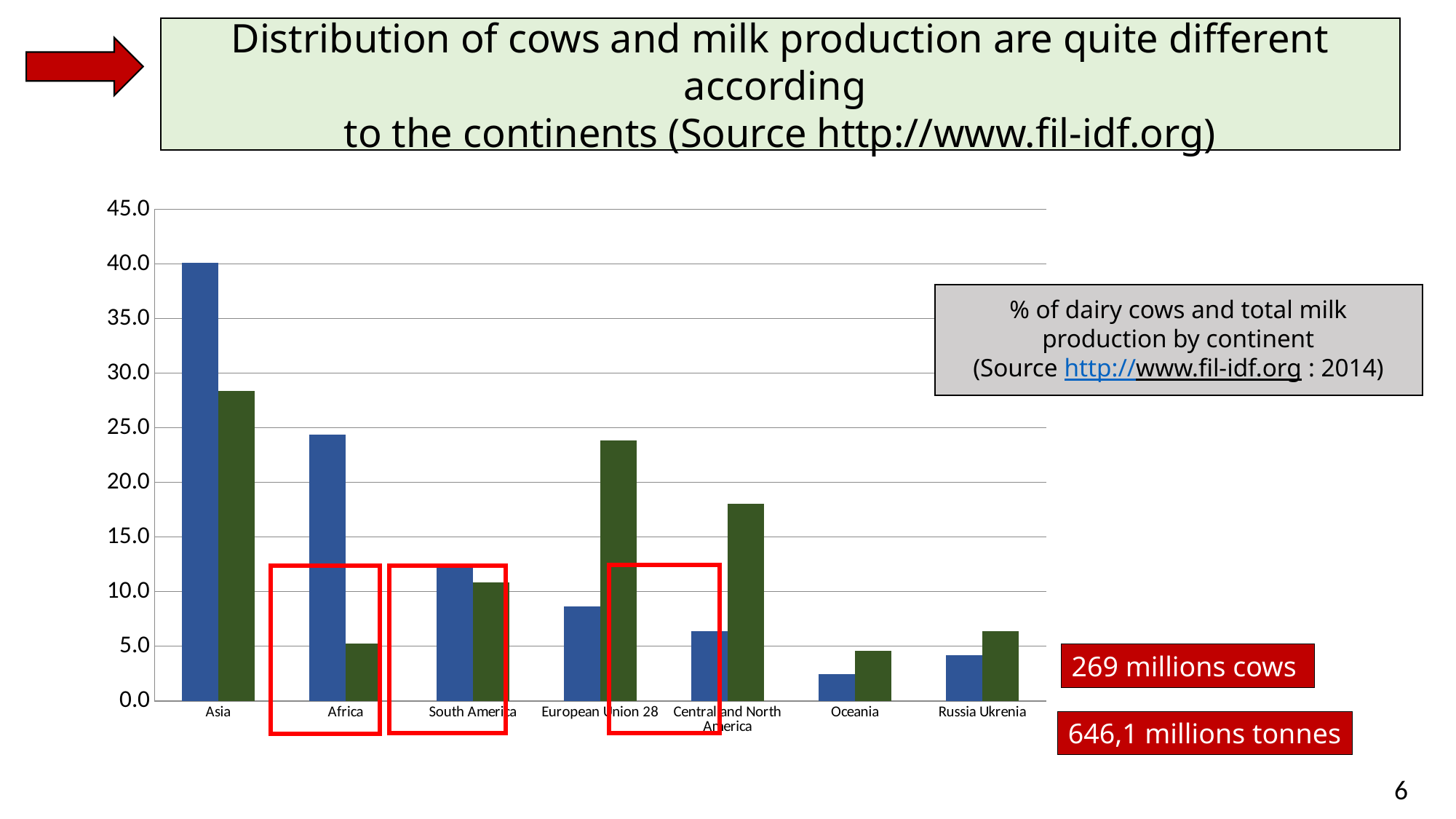
What kind of chart is shown on the slide? bar chart Is the green bar for European Union 28 greater or less than 20.0? greater Which category has the tallest green bar? Asia Is the blue bar for Africa greater or less than 20.0? greater According to the text box on the chart, what does the chart show? % of dairy cows and total milk production by continent Which category has the tallest blue bar? Asia Which category has the shortest green bar? Oceania For European Union 28, which bar is taller, the blue bar or the green bar? green bar Which category has the shortest blue bar? Oceania How many continent categories are shown on the x axis of the chart? 7 Is the green bar for Africa greater or less than 10.0? less For Africa, which bar is taller, the blue bar or the green bar? blue bar